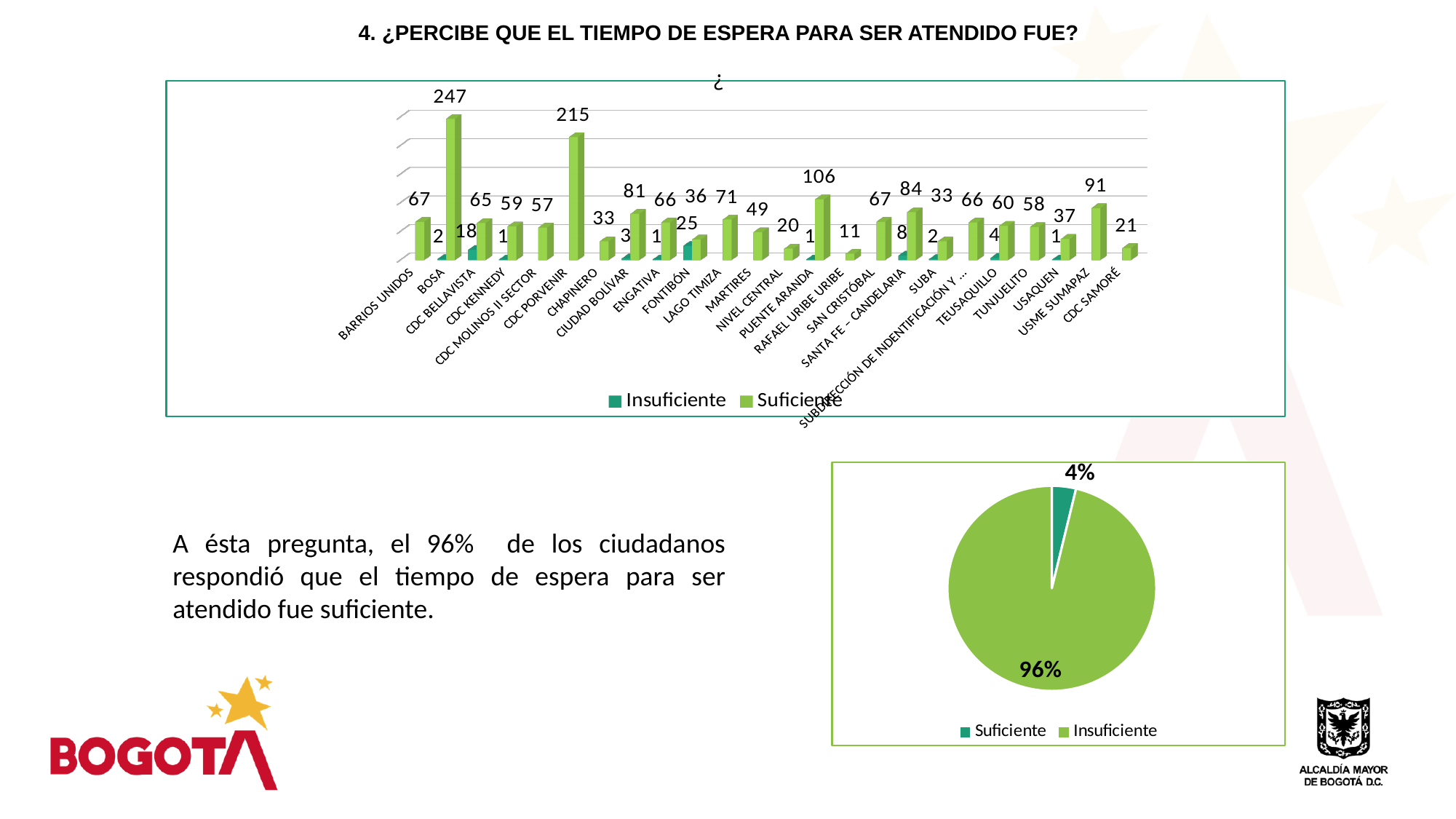
In the bar chart, which category has the highest Suficiente value? BOSA In the bar chart, what is the Suficiente value for PUENTE ARANDA? 106 In the bar chart, which category has the lowest Suficiente value? RAFAEL URIBE URIBE How many series does the legend of the bar chart list? 2 In the bar chart, what is the difference between the Suficiente values for BOSA and CDC PORVENIR? 32 In the bar chart, what is the Suficiente value for BOSA? 247 In the bar chart, which has a larger Suficiente value, PUENTE ARANDA or USME SUMAPAZ? PUENTE ARANDA What kind of chart is the chart at the bottom right of the slide? Pie chart How many categories are shown on the x axis of the bar chart? 24 In the pie chart, what share does the smaller slice have? 4% In the pie chart, what share does the larger slice have? 96% In the bar chart, what is the Suficiente value for USME SUMAPAZ? 91